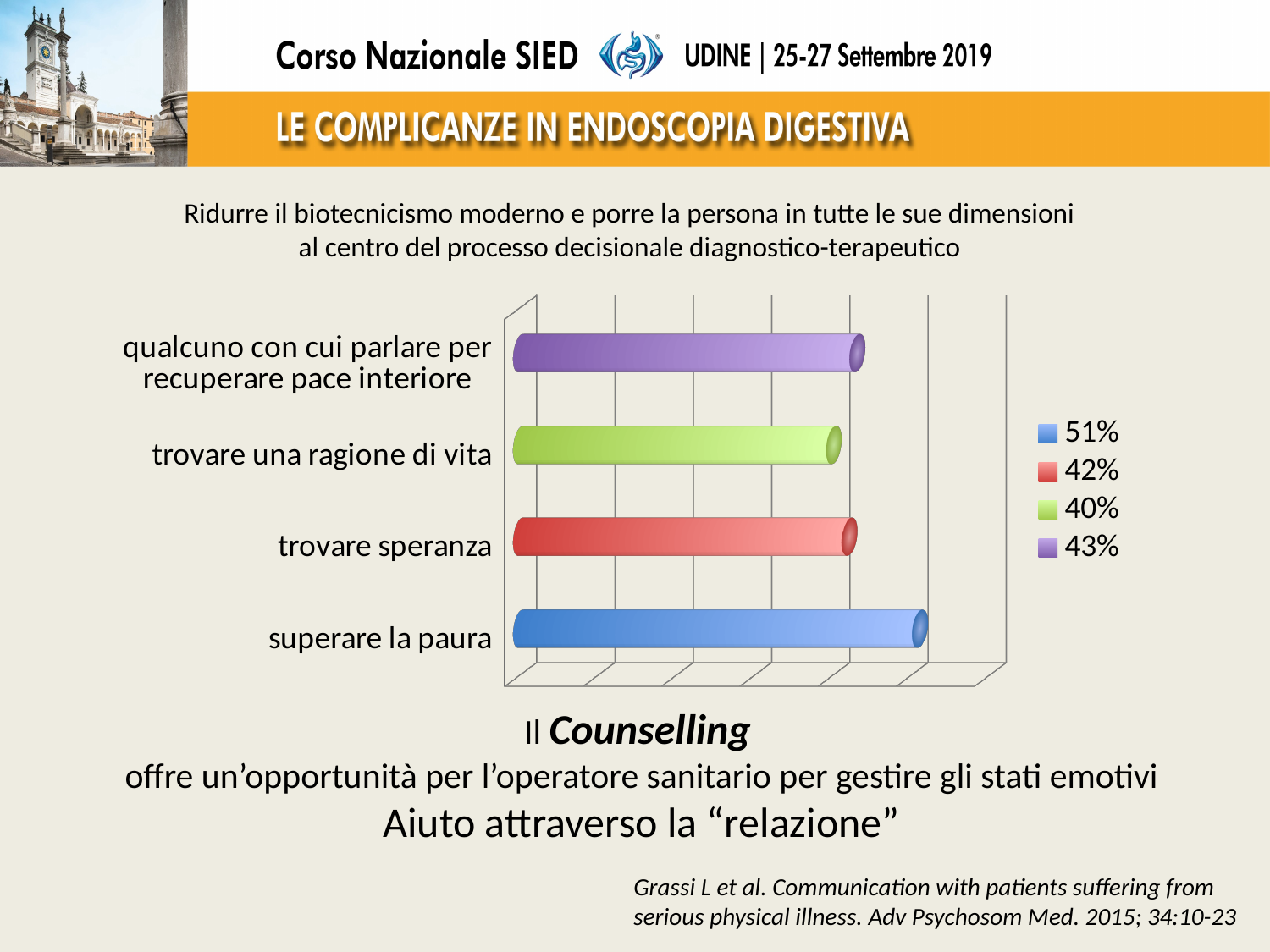
What is the difference between the values for 'superare la paura' and 'trovare speranza'? 9% What colour is the bar for 'trovare speranza'? red What is the value for 'trovare speranza'? 42% Which category has the highest value? superare la paura What is the value for 'superare la paura'? 51% Which category has the lowest value? trovare una ragione di vita How many entries does the legend of the bar chart list? 4 What is the value for 'trovare una ragione di vita'? 40% What is the value for 'qualcuno con cui parlare per recuperare pace interiore'? 43% Which is larger, the value for 'superare la paura' or the value for 'qualcuno con cui parlare per recuperare pace interiore'? superare la paura What kind of chart is shown on the slide? bar chart How many categories does the bar chart show? 4